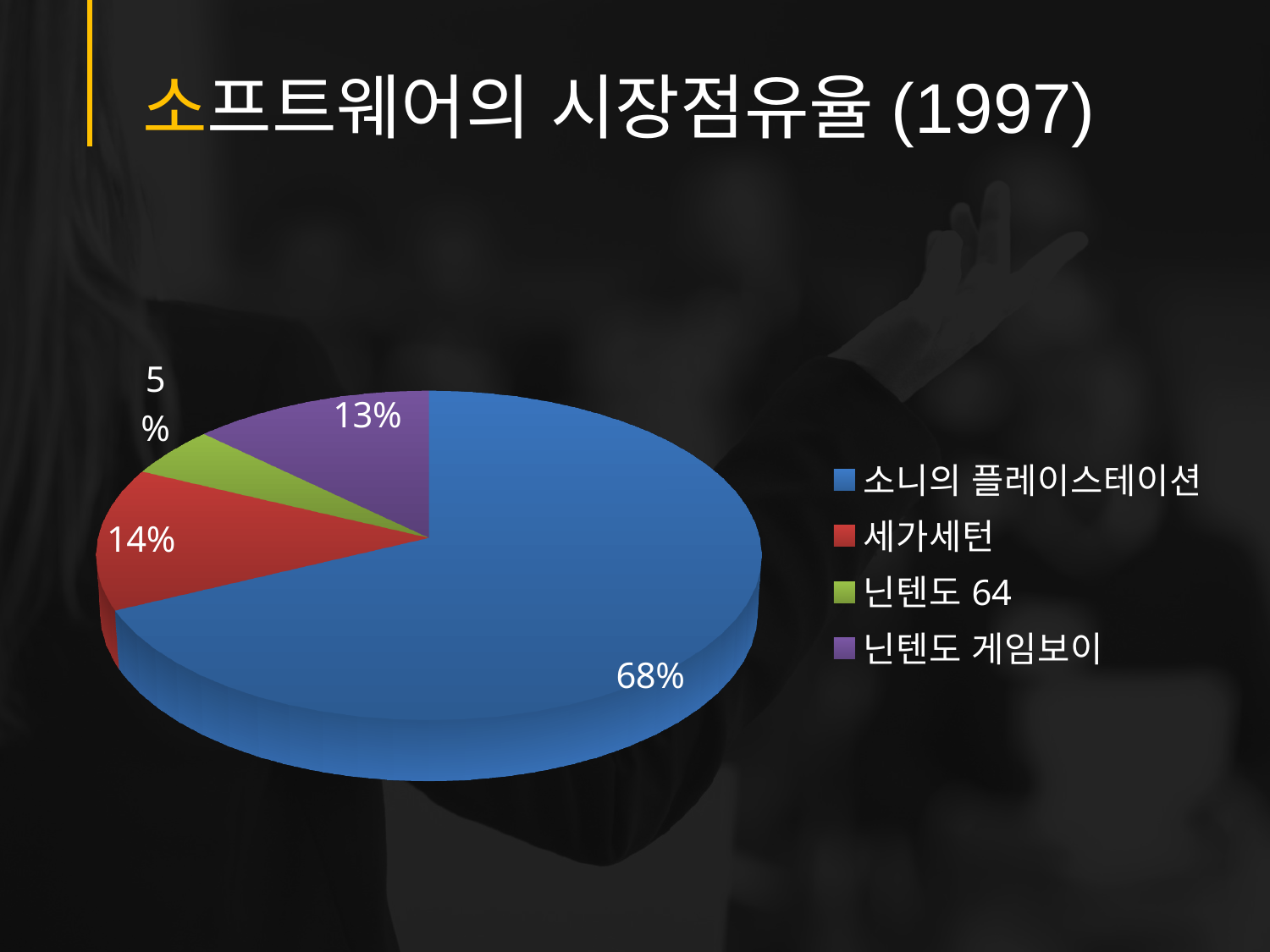
What kind of chart is shown on the slide? Pie chart What share of the pie does 소니의 플레이스테이션 have? 68% What is the title of the slide containing the chart? 소프트웨어의 시장점유율 (1997) What share of the pie does 닌텐도 게임보이 have? 13% What share of the pie does 닌텐도 64 have? 5% Which colour represents 닌텐도 게임보이 in the legend? Purple What share of the pie does 세가세턴 have? 14% Which category has the smallest slice of the pie? 닌텐도 64 Which category has the largest slice of the pie? 소니의 플레이스테이션 Which has a larger share, 세가세턴 or 닌텐도 게임보이? 세가세턴 What is the difference in percentage points between 소니의 플레이스테이션 and 세가세턴? 54 How many slices does the pie chart have? 4